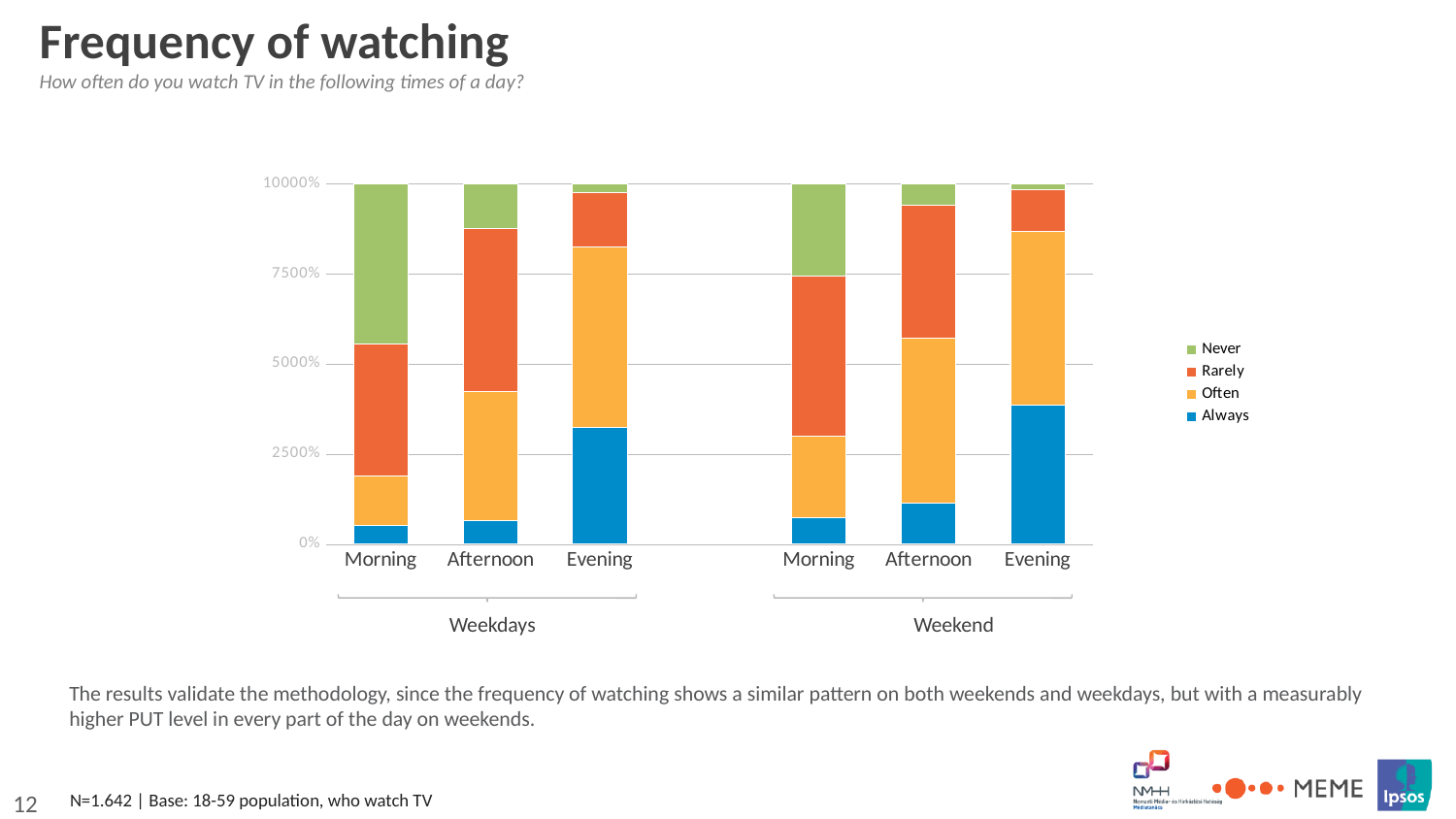
How many bars are plotted in the chart? 6 What are the two groups of bars labelled below the x axis? Weekdays and Weekend Is the 'Always' segment larger for Weekend Evening or Weekday Evening? Weekend Evening Which legend entry is shown in blue? Always Is the 'Always' segment for Weekday Morning greater or less than 2500%? less What kind of chart is shown on the slide? Stacked bar chart Is the 'Always' segment for Weekend Evening greater or less than 5000%? less Is the 'Always' segment for Weekday Evening greater or less than 2500%? greater How many series does the legend list? 4 Which bar has the largest 'Never' segment? Weekday Morning Which bar has the largest 'Always' segment? Weekend Evening Is the 'Never' segment larger for Weekday Morning or Weekend Morning? Weekday Morning